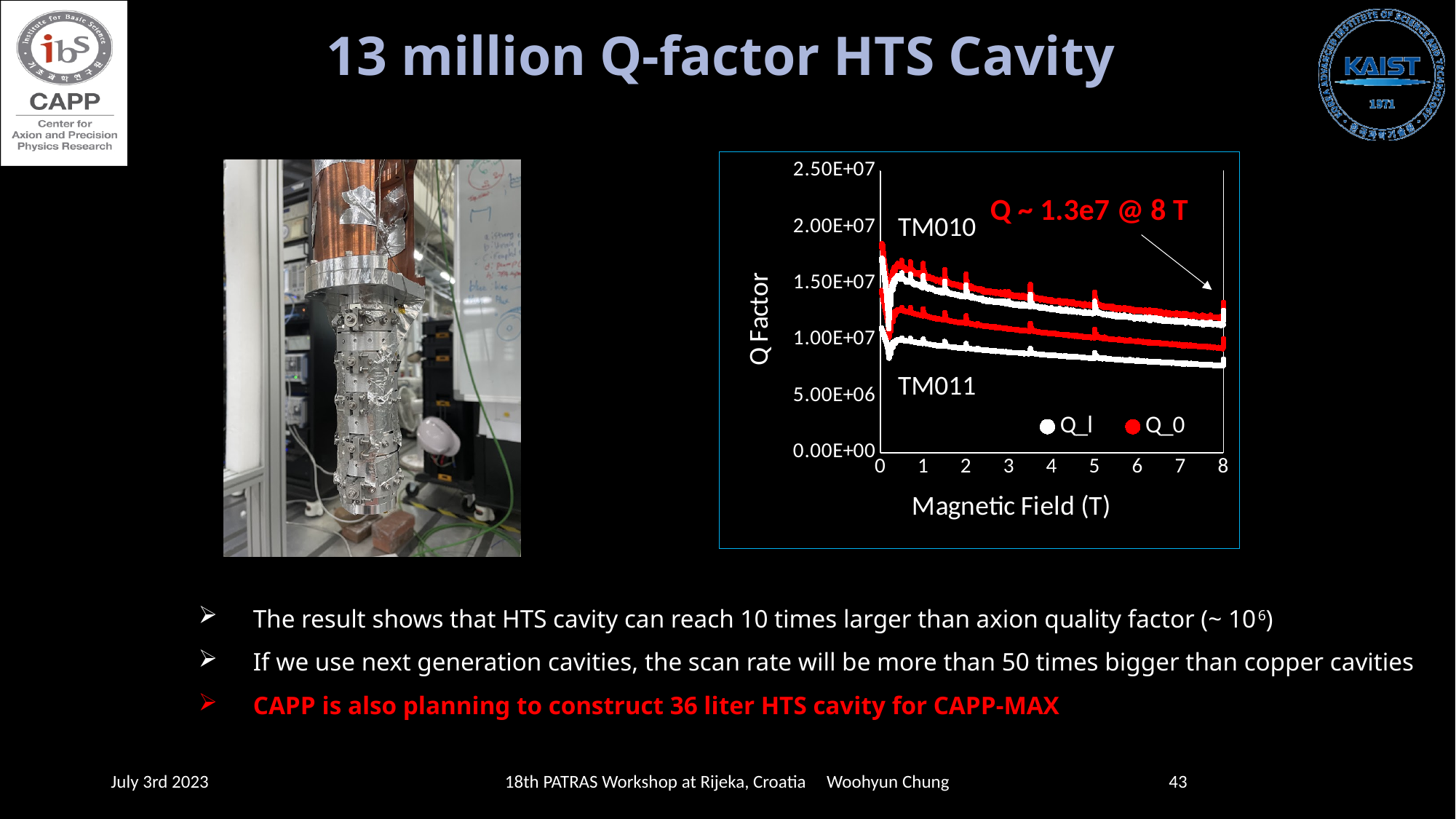
What is the label of the x axis of the chart? Magnetic Field (T) As the magnetic field increases from 1 T to 8 T, do the Q factor curves rise or fall? fall Is the Q_l value of the TM011 mode at 8 T greater or less than 1.00E+07? less What is the highest tick value shown on the Q Factor axis? 2.50E+07 Which mode has the higher Q factor across the magnetic field range, TM010 or TM011? TM010 Is the Q_0 value of the TM010 mode at 4 T greater or less than 2.00E+07? less What are the two series named in the chart legend? Q_l and Q_0 What is the highest magnetic field value shown on the x axis? 8 What kind of chart is shown on the slide? scatter chart For the TM010 mode, which series has the higher Q factor at 4 T, Q_0 or Q_l? Q_0 Is the Q_0 value of the TM010 mode at 8 T greater or less than 1.00E+07? greater How many series does the chart legend list? 2